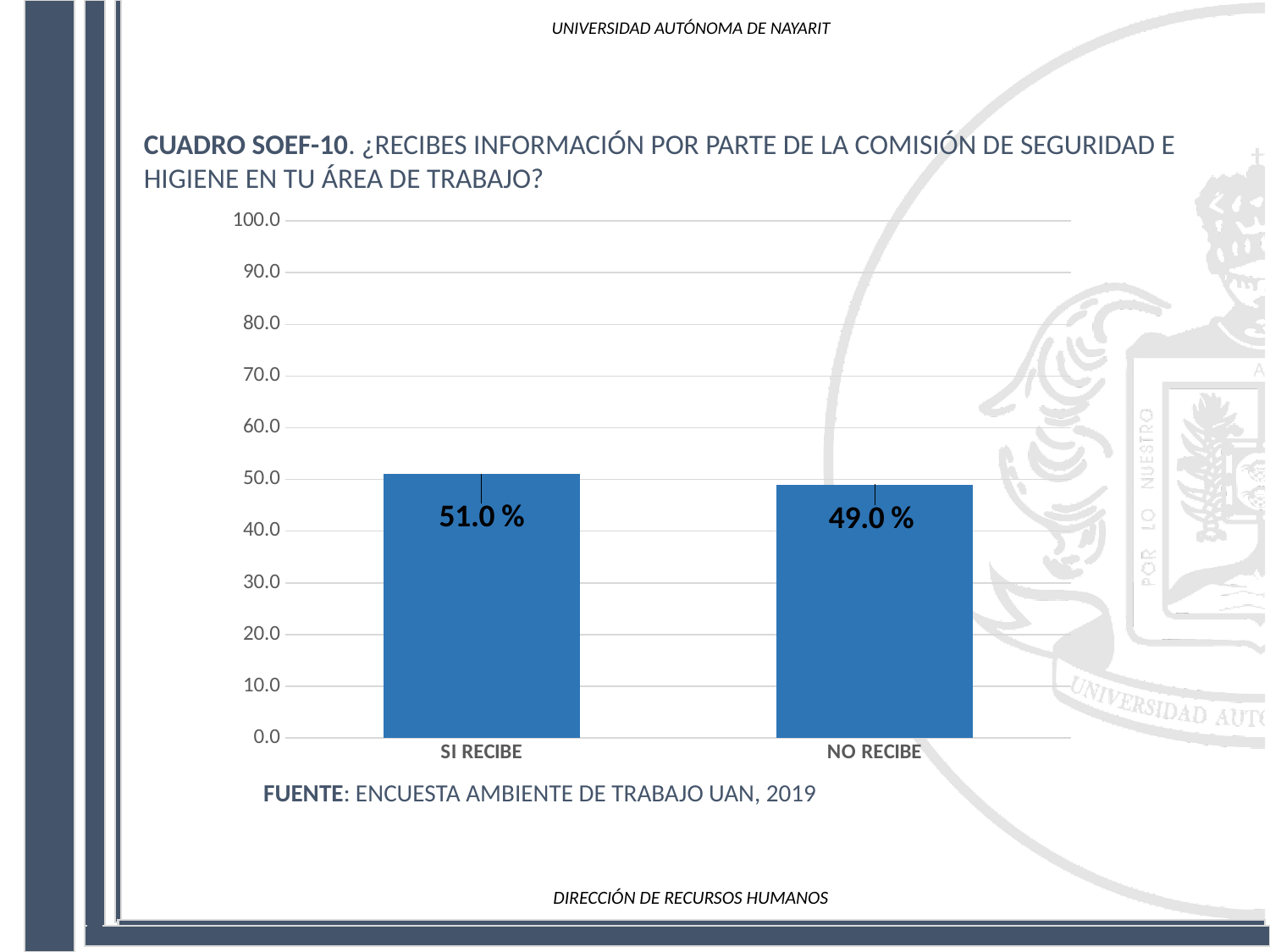
What is the value for NO RECIBE? 49.0 % Is the value for SI RECIBE greater or less than 40.0? greater What is the value for SI RECIBE? 51.0 % Which is larger, the value for SI RECIBE or the value for NO RECIBE? SI RECIBE Is the value for NO RECIBE greater or less than 50.0? less What is the difference between the values for SI RECIBE and NO RECIBE? 2.0 % What kind of chart is shown on the slide? bar chart How many categories are shown on the x axis? 2 Which category has the highest value? SI RECIBE Which category has the lowest value? NO RECIBE What is the total of the two values shown in the chart? 100.0 % What is the source cited below the chart? ENCUESTA AMBIENTE DE TRABAJO UAN, 2019